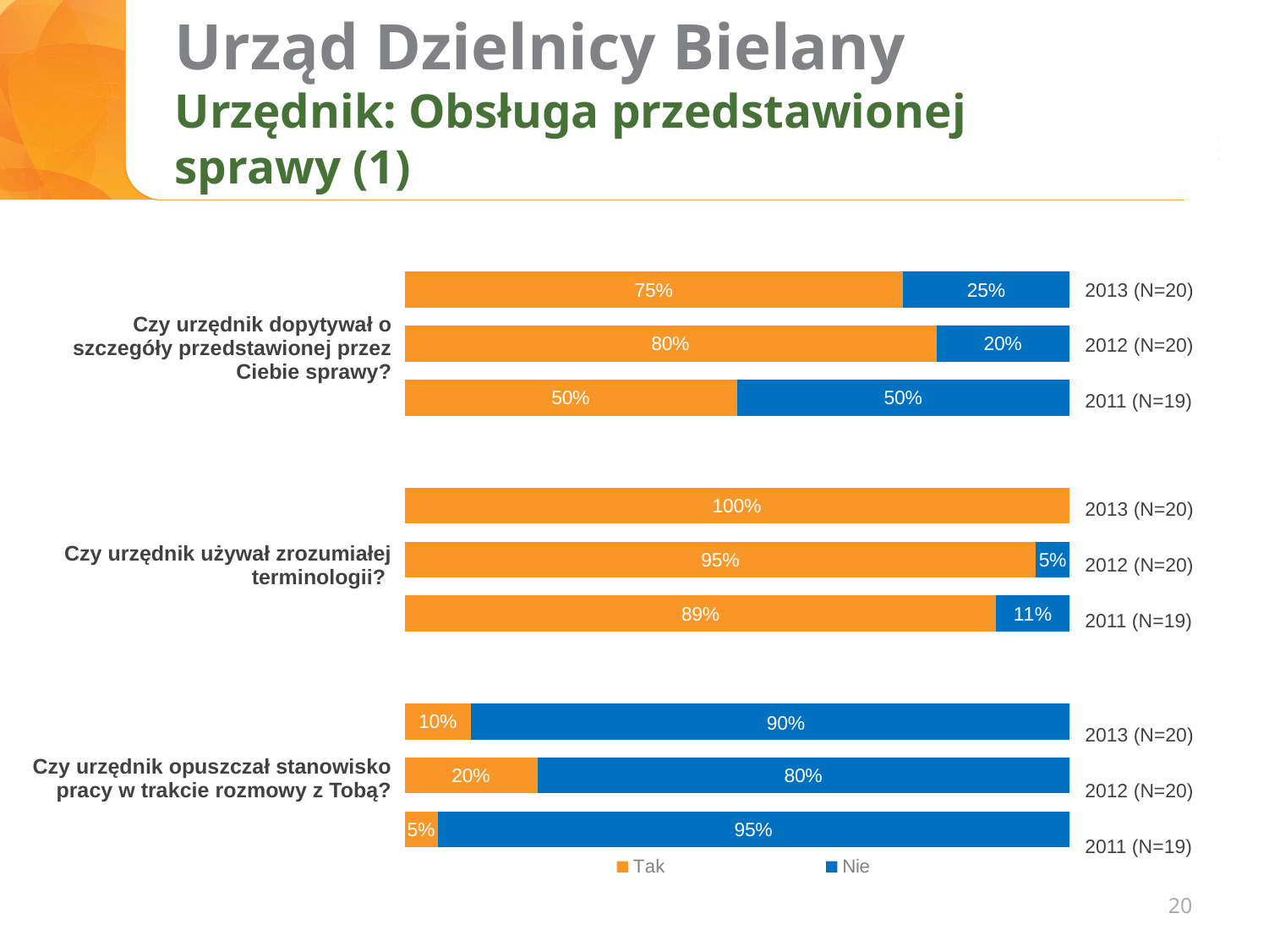
How many series does the legend list? 2 What is the 'Nie' value for 2012 (N=20) for the question 'Czy urzędnik dopytywał o szczegóły przedstawionej przez Ciebie sprawy?' 20% What kind of chart is shown on the slide? stacked bar chart For the question 'Czy urzędnik opuszczał stanowisko pracy w trakcie rozmowy z Tobą?', which year has the lowest 'Tak' value? 2011 (N=19) What is the 'Nie' value for 2013 (N=20) for the question 'Czy urzędnik opuszczał stanowisko pracy w trakcie rozmowy z Tobą?' 90% What is the 'Nie' value for 2011 (N=19) for the question 'Czy urzędnik używał zrozumiałej terminologii?' 11% What are the two series named in the legend? Tak and Nie What is the 'Tak' value for 2013 (N=20) for the question 'Czy urzędnik dopytywał o szczegóły przedstawionej przez Ciebie sprawy?' 75% For the question 'Czy urzędnik używał zrozumiałej terminologii?', which year has the highest 'Tak' value? 2013 (N=20) For the question 'Czy urzędnik opuszczał stanowisko pracy w trakcie rozmowy z Tobą?', is the 'Nie' value for 2012 (N=20) larger or smaller than the 'Nie' value for 2011 (N=19)? smaller What is the 'Tak' value for 2013 (N=20) for the question 'Czy urzędnik używał zrozumiałej terminologii?' 100% For the question 'Czy urzędnik dopytywał o szczegóły przedstawionej przez Ciebie sprawy?', what is the difference between the 'Tak' values for 2012 (N=20) and 2011 (N=19)? 30%